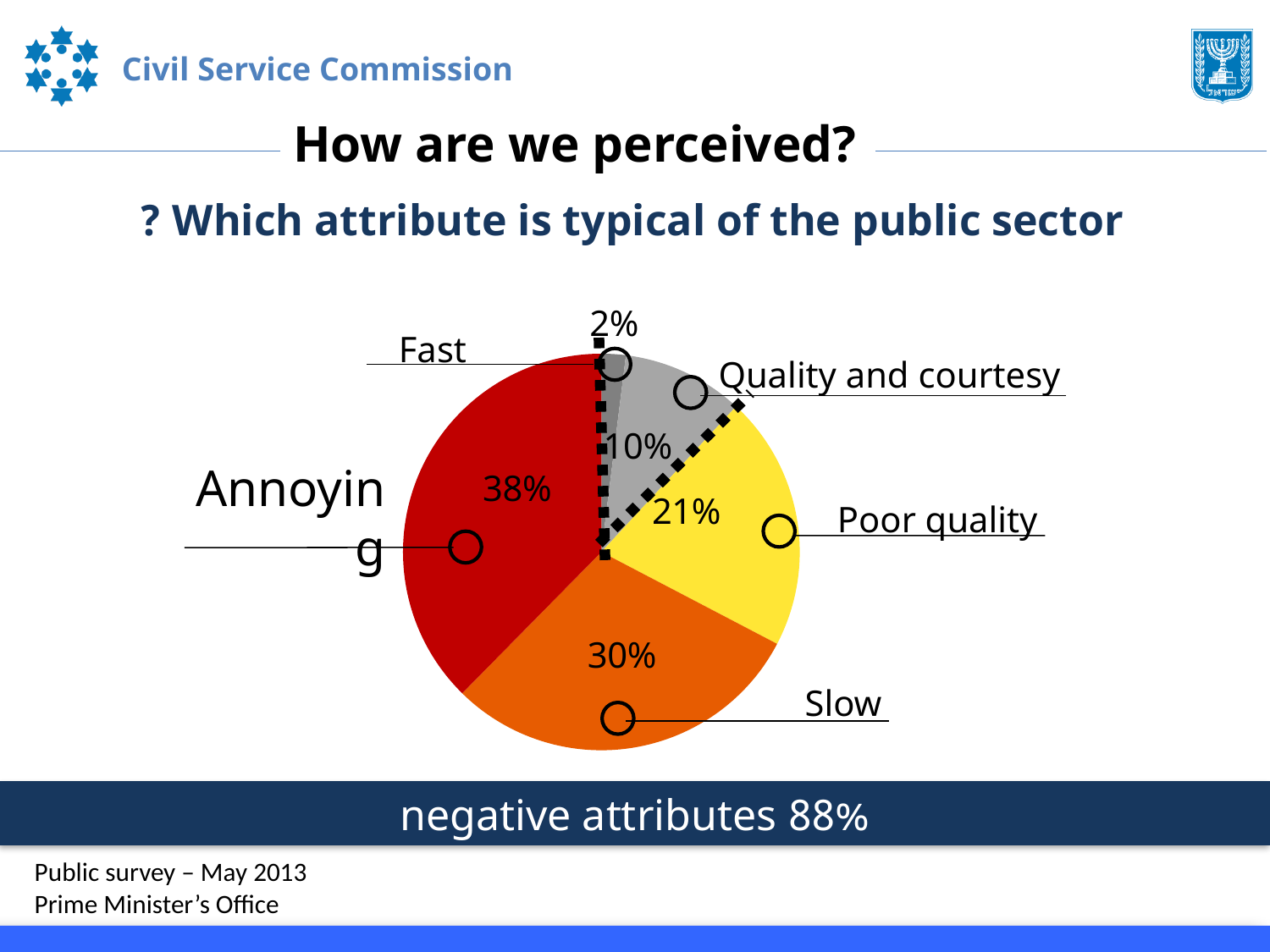
How many slices does the pie chart have? 5 What share of the pie is labelled "Fast"? 2% Which attribute has the largest slice of the pie? Annoying What share of the pie is labelled "Quality and courtesy"? 10% What share of the pie is labelled "Slow"? 30% Which slice is larger, "Poor quality" or "Quality and courtesy"? Poor quality What colour is the "Annoying" slice of the pie? Red Which attribute has the smallest slice of the pie? Fast What share of the pie is labelled "Annoying"? 38% What share of the pie is labelled "Poor quality"? 21% What is the difference in percentage points between the "Annoying" and "Slow" slices? 8 What kind of chart is shown on the slide? Pie chart